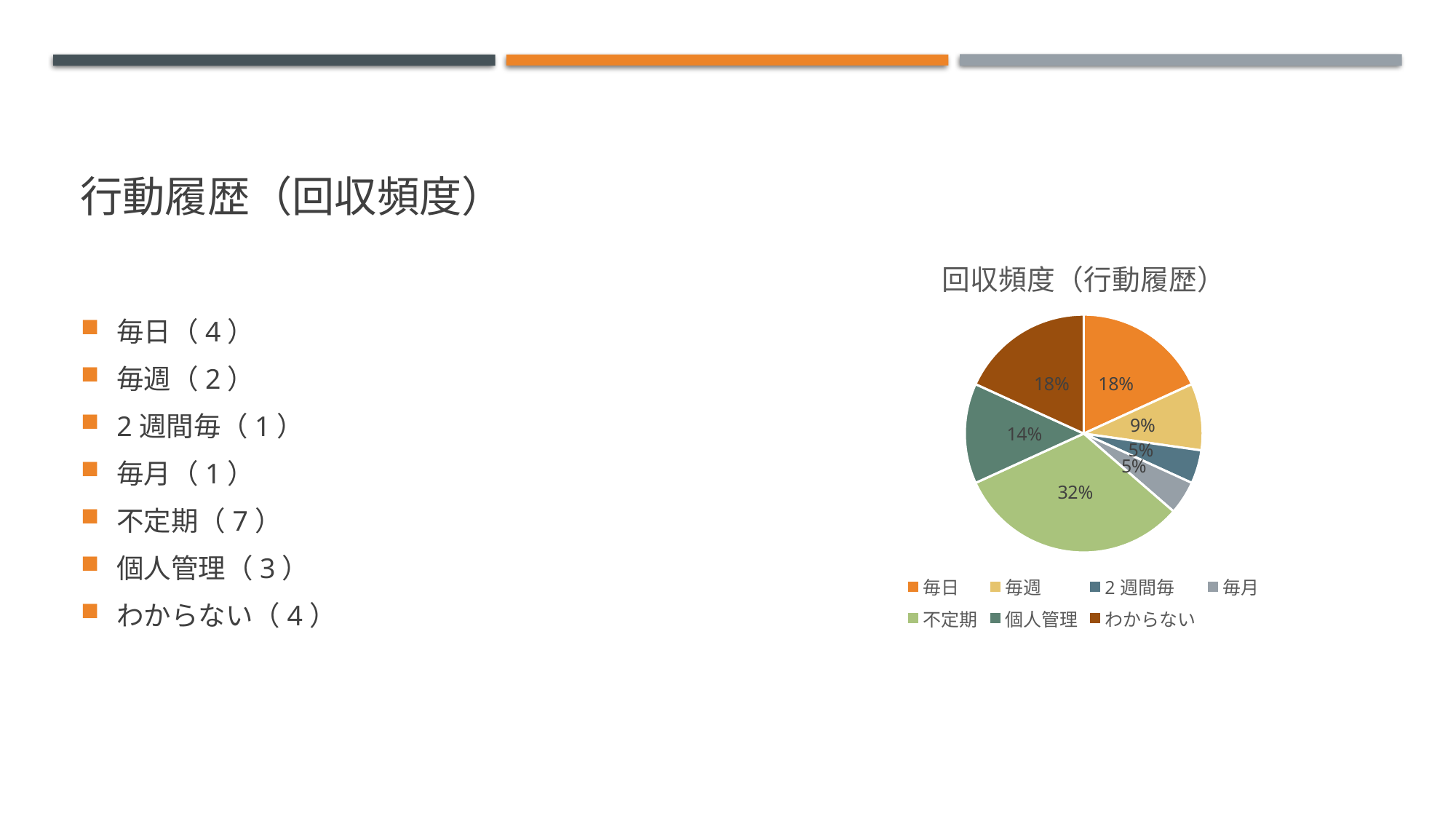
How many slices does the pie chart have? 7 Which category has the largest share of the pie? 不定期 What is the title of the chart? 回収頻度（行動履歴） Which slice is larger, 毎週 or 個人管理? 個人管理 What percentage does the 毎週 slice show? 9% Which legend entry is shown in light green? 不定期 What is the difference in percentage points between the 不定期 slice and the 個人管理 slice? 18 What share of the pie does the わからない slice represent? 18% What percentage does the 不定期 slice show? 32% What percentage does the 毎日 slice show? 18% What percentage does the 個人管理 slice show? 14% What kind of chart is shown on the slide? pie chart